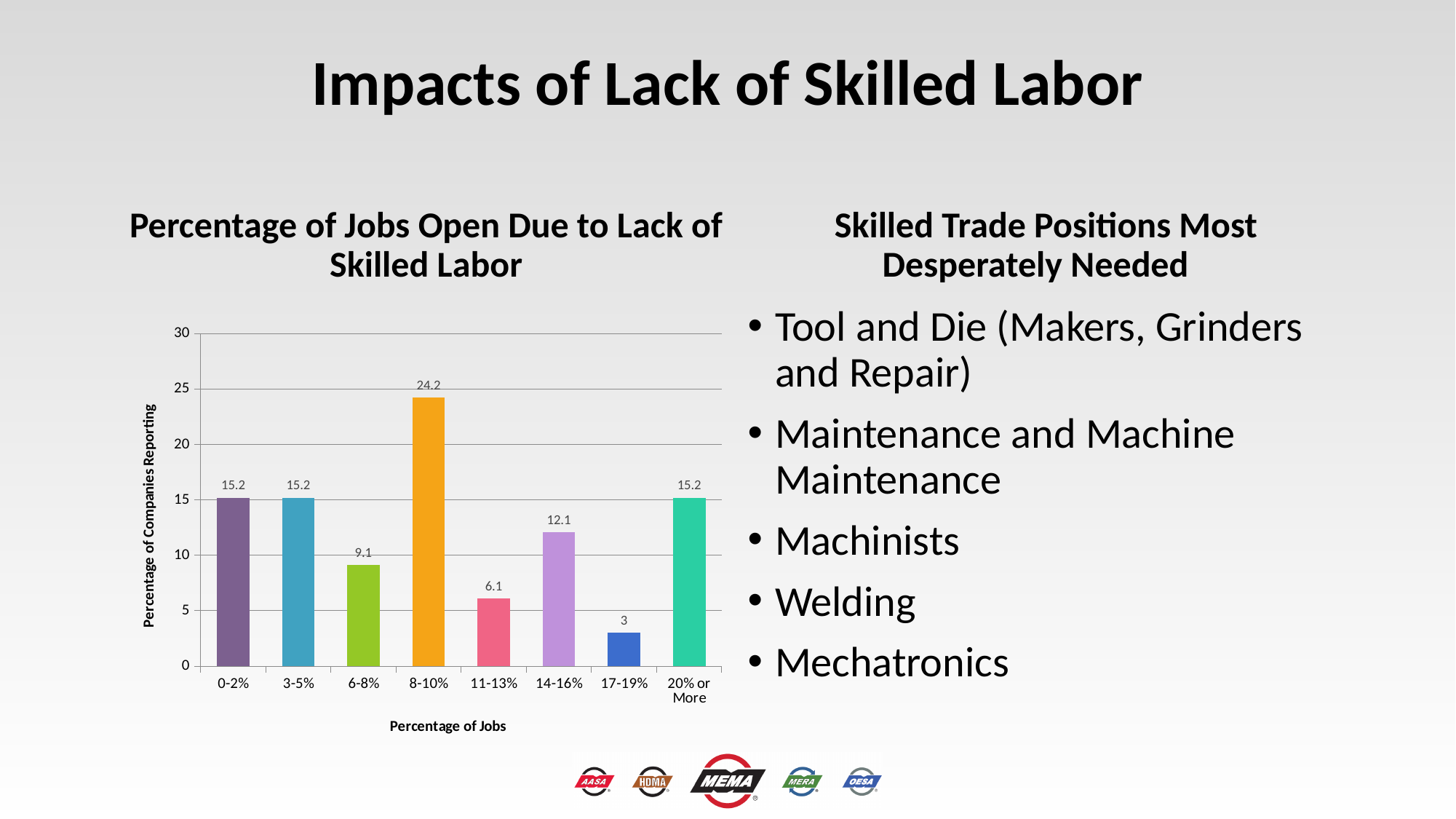
What is the title of the chart? Percentage of Jobs Open Due to Lack of Skilled Labor Is the value for 11-13% greater or less than 10? less What percentage of companies reported 8-10% of jobs open due to lack of skilled labor? 24.2 Which category has the highest percentage of companies reporting? 8-10% How many categories are shown on the x axis of the chart? 8 What is the value for the 6-8% category? 9.1 What kind of chart is shown on the slide? bar chart What is the difference between the values for 8-10% and 11-13%? 18.1 Which category has the lowest percentage of companies reporting? 17-19% Which is larger, the value for 6-8% or the value for 14-16%? 14-16% What is the value for the 17-19% category? 3 What is the value for the 14-16% category? 12.1